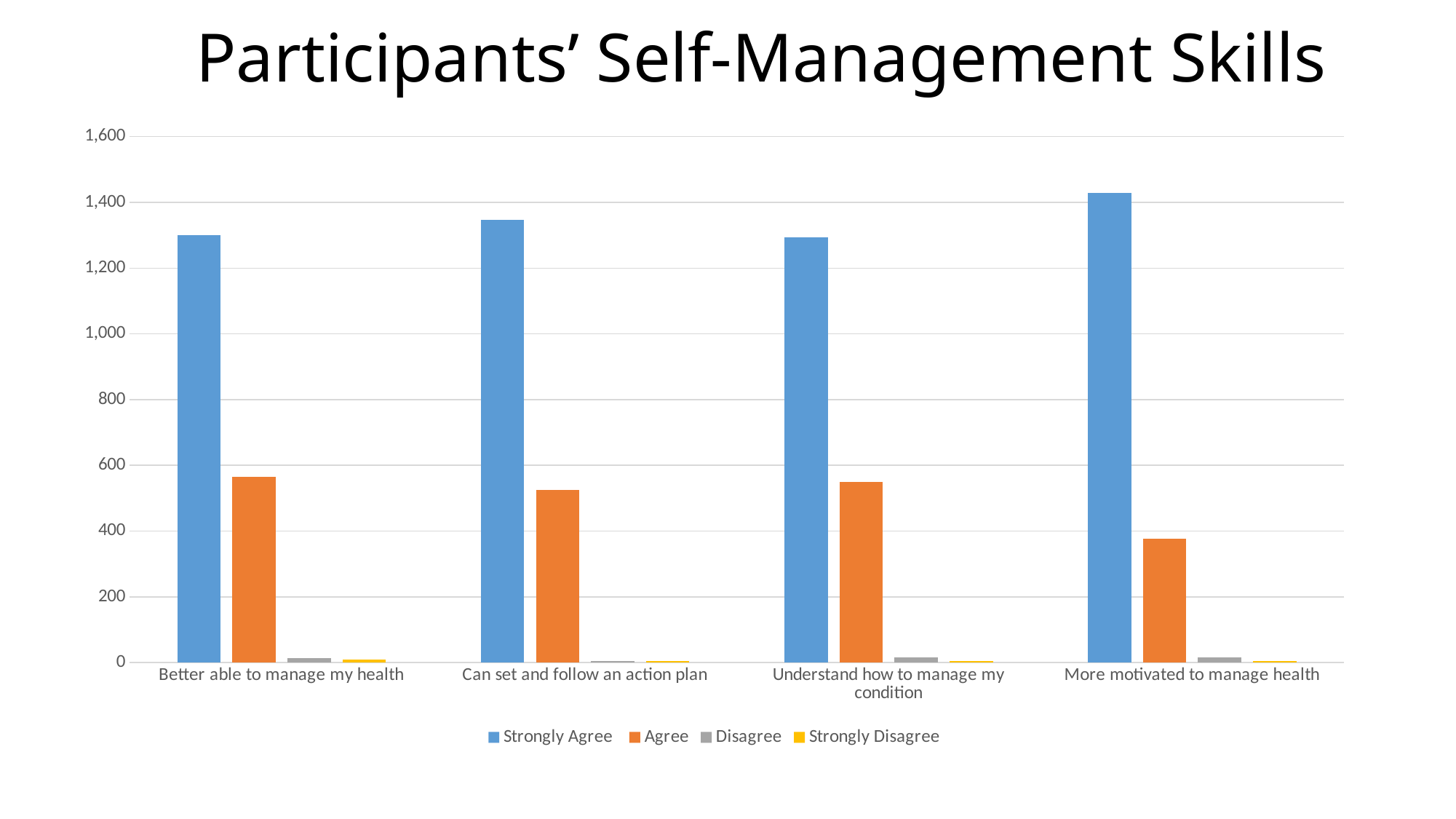
What is the title of the chart? Participants' Self-Management Skills Which category has the lowest Agree value? More motivated to manage health Which is larger for Understand how to manage my condition: Strongly Agree or Agree? Strongly Agree Is the Agree value for More motivated to manage health greater or less than 400? less Is the Strongly Agree value for Can set and follow an action plan greater or less than 1,200? greater Is the Strongly Agree value for More motivated to manage health greater or less than 1,400? greater Which category has the highest Strongly Agree value? More motivated to manage health How many series does the legend list? 4 Which colour represents the Strongly Disagree series in the legend? yellow What kind of chart is shown on the slide? bar chart How many categories are shown on the x axis? 4